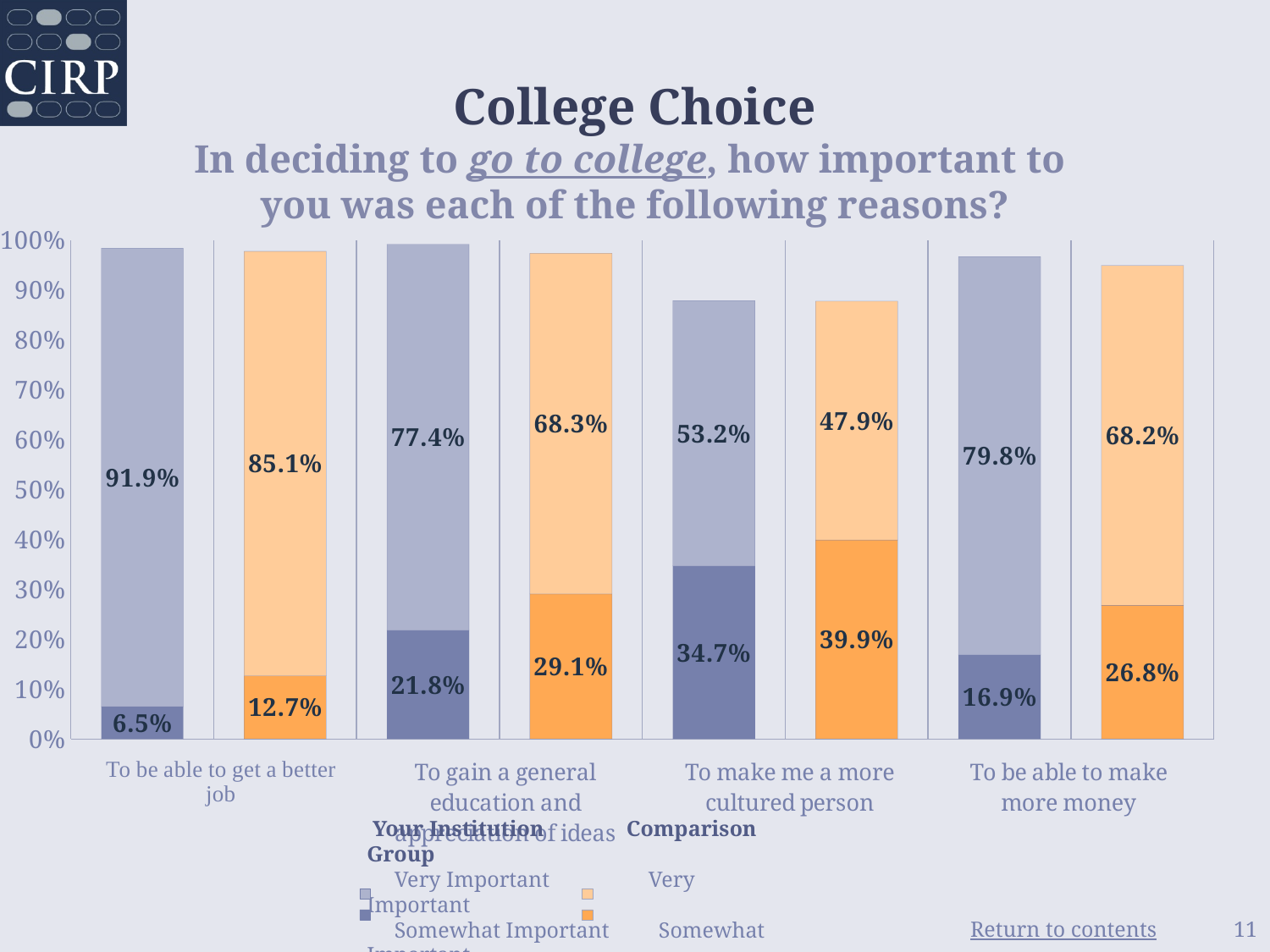
What percentage of students at Your Institution rated 'To be able to get a better job' as Very Important? 91.9% What percentage of the Comparison Group rated 'To be able to make more money' as Somewhat Important? 26.8% How many reasons (categories) are shown on the x axis of the chart? 4 For 'To gain a general education and appreciation of ideas', which group has the larger Somewhat Important percentage, Your Institution or the Comparison Group? Comparison Group Which reason has the highest Very Important percentage for Your Institution? To be able to get a better job What type of chart is shown on the slide? Stacked bar chart Which reason has the lowest Very Important percentage for the Comparison Group? To make me a more cultured person What is the difference between the Very Important and Somewhat Important percentages for Your Institution on 'To gain a general education and appreciation of ideas'? 55.6% What is the difference between Your Institution's and the Comparison Group's Very Important percentages for 'To be able to make more money'? 11.6% How many series does the chart's legend list? 4 What is the combined Very Important and Somewhat Important total for Your Institution on 'To make me a more cultured person'? 87.9% What percentage of the Comparison Group rated 'To make me a more cultured person' as Very Important? 47.9%